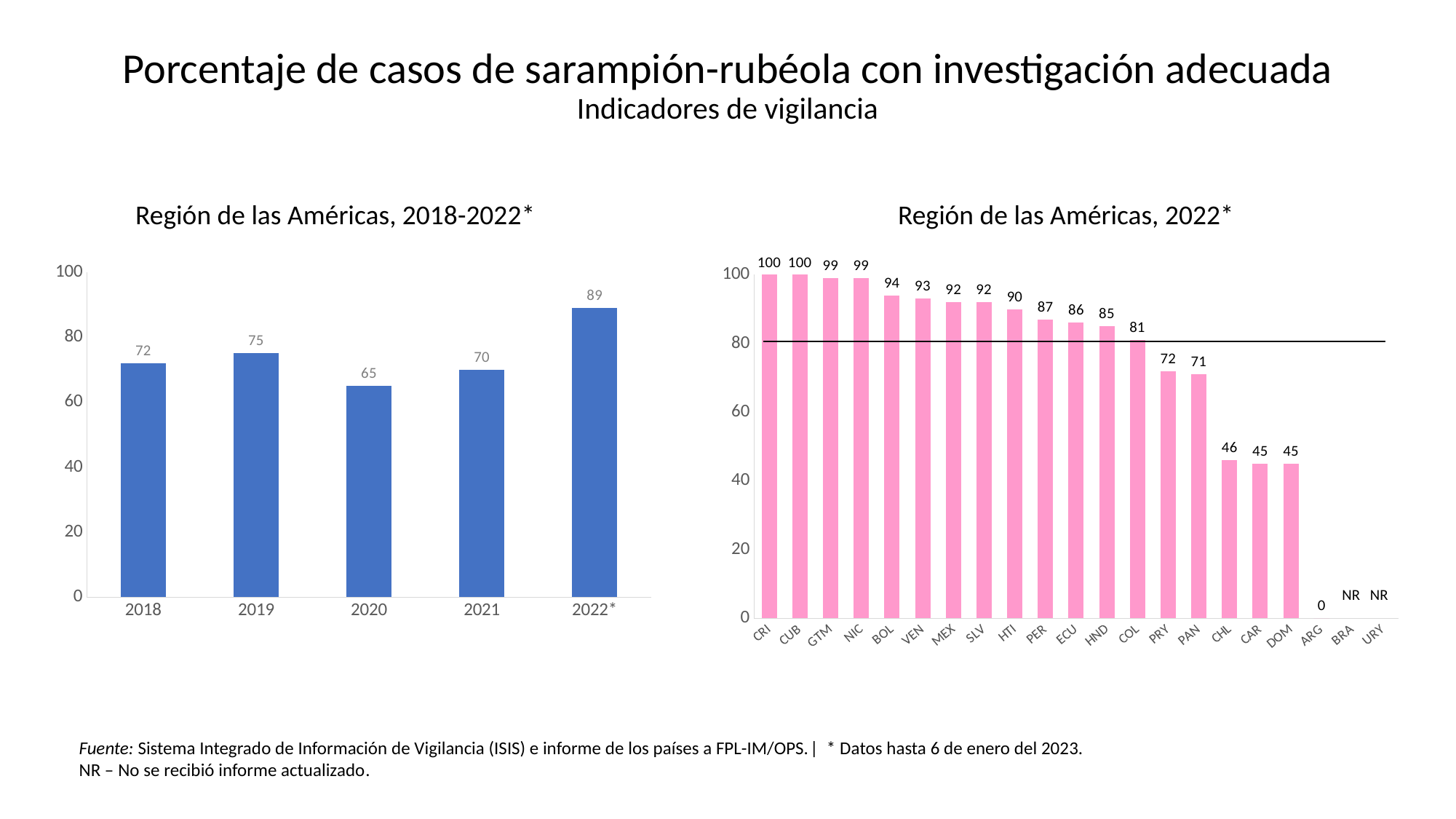
In the chart 'Región de las Américas, 2022*', what is the difference between the values for COL and CHL? 35 What kind of chart is 'Región de las Américas, 2018-2022*'? Bar chart In the chart 'Región de las Américas, 2022*', what is the value for HTI? 90 In the chart 'Región de las Américas, 2018-2022*', what is the value for 2019? 75 In the chart 'Región de las Américas, 2018-2022*', which year has the highest value? 2022* In the chart 'Región de las Américas, 2018-2022*', which year has the lowest value? 2020 In the chart 'Región de las Américas, 2018-2022*', what is the difference between the values for 2022* and 2021? 19 In the chart 'Región de las Américas, 2018-2022*', how many years are shown on the x axis? 5 In the chart 'Región de las Américas, 2022*', what is the value for PAN? 71 In the chart 'Región de las Américas, 2022*', which is larger, the value for BOL or the value for ECU? BOL In the chart 'Región de las Américas, 2022*', which countries are marked NR? BRA and URY In the chart 'Región de las Américas, 2022*', how many countries are listed on the x axis? 21